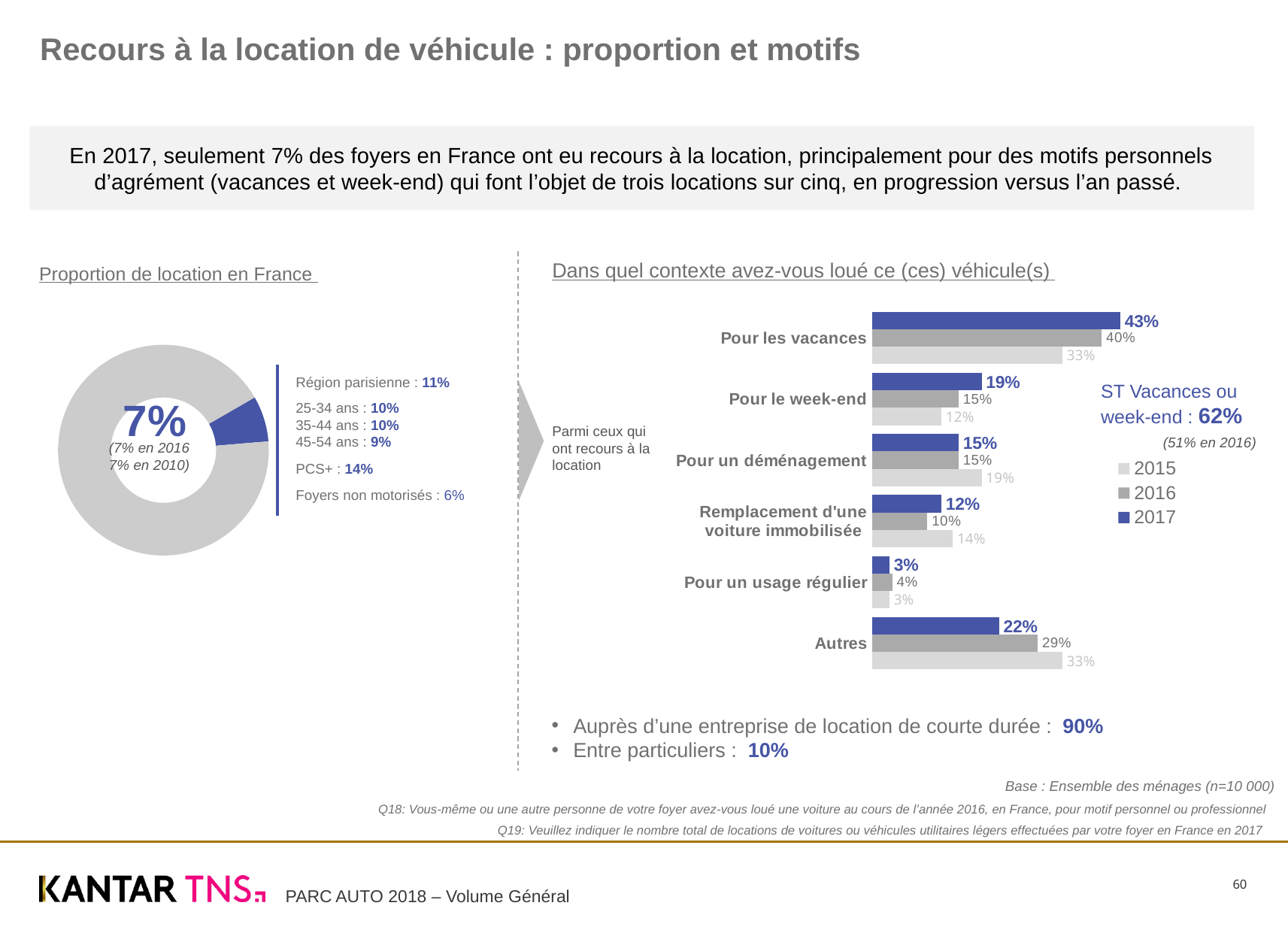
How many categories does the bar chart 'Dans quel contexte avez-vous loué ce (ces) véhicule(s)' show? 6 In the bar chart 'Dans quel contexte avez-vous loué ce (ces) véhicule(s)', what is the difference between the 2017 and 2016 values for 'Pour le week-end'? 4% How many series does the legend of the bar chart 'Dans quel contexte avez-vous loué ce (ces) véhicule(s)' list? 3 In the bar chart 'Dans quel contexte avez-vous loué ce (ces) véhicule(s)', what is the 2016 value for 'Remplacement d'une voiture immobilisée'? 10% In the bar chart 'Dans quel contexte avez-vous loué ce (ces) véhicule(s)', which category has the highest 2017 value? Pour les vacances In the bar chart 'Dans quel contexte avez-vous loué ce (ces) véhicule(s)', did the value for 'Pour les vacances' rise or fall from 2015 to 2017? rise In the bar chart 'Dans quel contexte avez-vous loué ce (ces) véhicule(s)', what is the 2015 value for 'Autres'? 33% In the bar chart 'Dans quel contexte avez-vous loué ce (ces) véhicule(s)', what is the 2017 value for 'Pour les vacances'? 43% What percentage is shown in the centre of the donut chart 'Proportion de location en France'? 7% In the bar chart 'Dans quel contexte avez-vous loué ce (ces) véhicule(s)', is the 2016 value for 'Autres' larger or smaller than the 2017 value for 'Autres'? larger What kind of chart is 'Dans quel contexte avez-vous loué ce (ces) véhicule(s)'? bar chart In the bar chart 'Dans quel contexte avez-vous loué ce (ces) véhicule(s)', which category has the lowest 2017 value? Pour un usage régulier